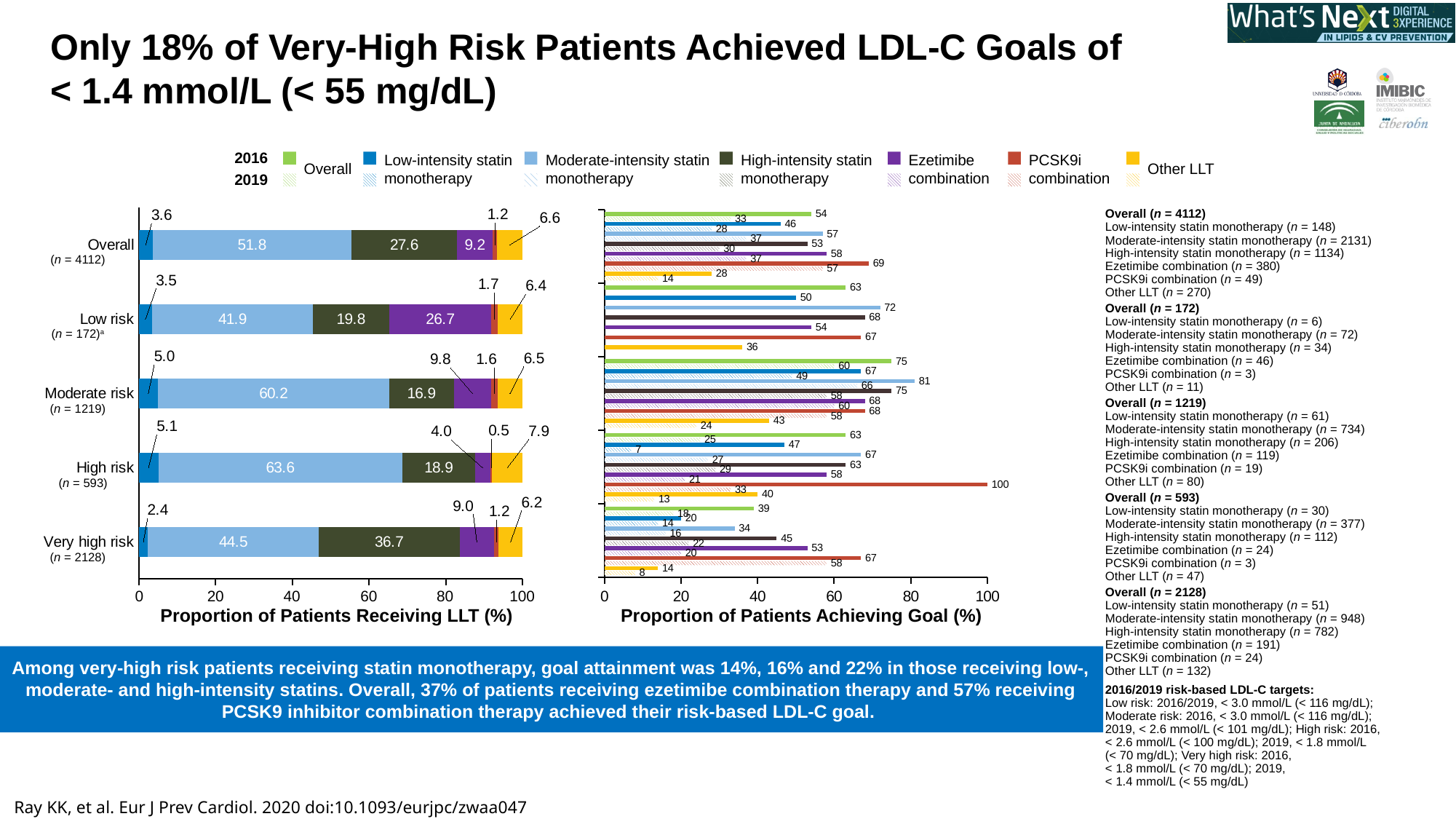
What type of chart is the left chart (Proportion of Patients Receiving LLT)? Stacked bar chart In the left chart (Proportion of Patients Receiving LLT), what percentage of very high risk patients received moderate-intensity statin monotherapy? 44.5 In the left chart (Proportion of Patients Receiving LLT), which risk group has the highest proportion receiving moderate-intensity statin monotherapy? High risk In the left chart (Proportion of Patients Receiving LLT), how much higher is the high-intensity statin monotherapy value for Very high risk than for Overall? 9.1 In the right chart (Proportion of Patients Achieving Goal), what is the highest value labelled on any bar? 100 In the left chart (Proportion of Patients Receiving LLT), what is the high-intensity statin monotherapy value for the Overall group? 27.6 In the left chart (Proportion of Patients Receiving LLT), how many risk groups are plotted? 5 In the right chart (Proportion of Patients Achieving Goal), what is the 2016 value for PCSK9i combination in the very high risk group? 67 How many treatment categories does the legend list? 7 In the left chart (Proportion of Patients Receiving LLT), which group has the larger ezetimibe combination value, Low risk or Moderate risk? Low risk In the left chart (Proportion of Patients Receiving LLT), which risk group has the lowest proportion receiving low-intensity statin monotherapy? Very high risk In the left chart (Proportion of Patients Receiving LLT), what is the Other LLT value for the High risk group? 7.9